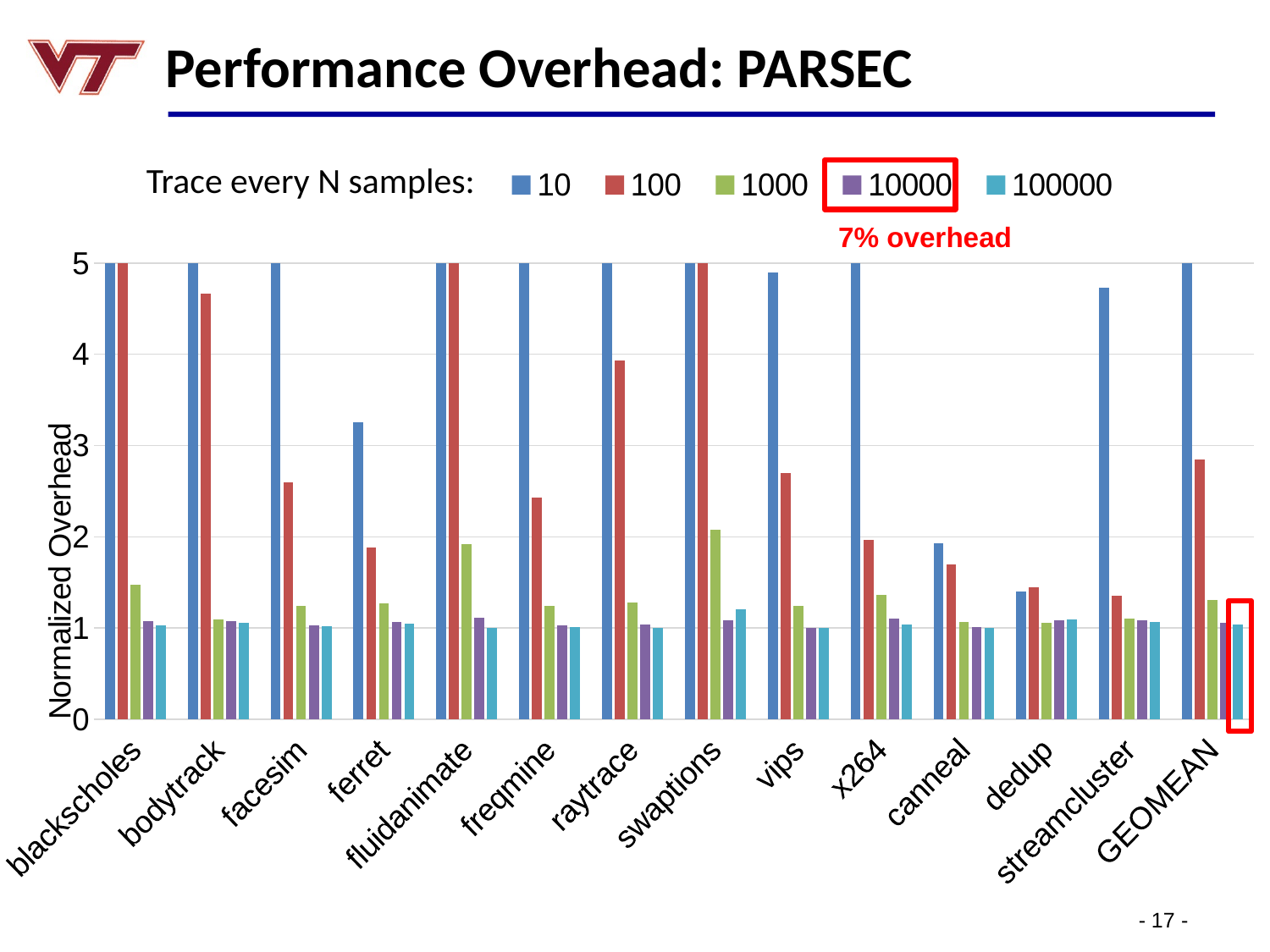
Is the value for ferret in the '10' series greater or less than 3? greater What kind of chart is shown on the slide? bar chart Which category has the lowest value in the '10' series? dedup Is the value for GEOMEAN in the '100' series greater or less than 3? less Is the value for bodytrack in the '100' series greater or less than 4? greater What is the label of the y axis? Normalized Overhead What is the title of the chart on the slide? Performance Overhead: PARSEC How many categories are shown along the x axis of the chart? 14 How many series does the chart's legend list? 5 For bodytrack, which series has the larger value: '10' or '100'? 10